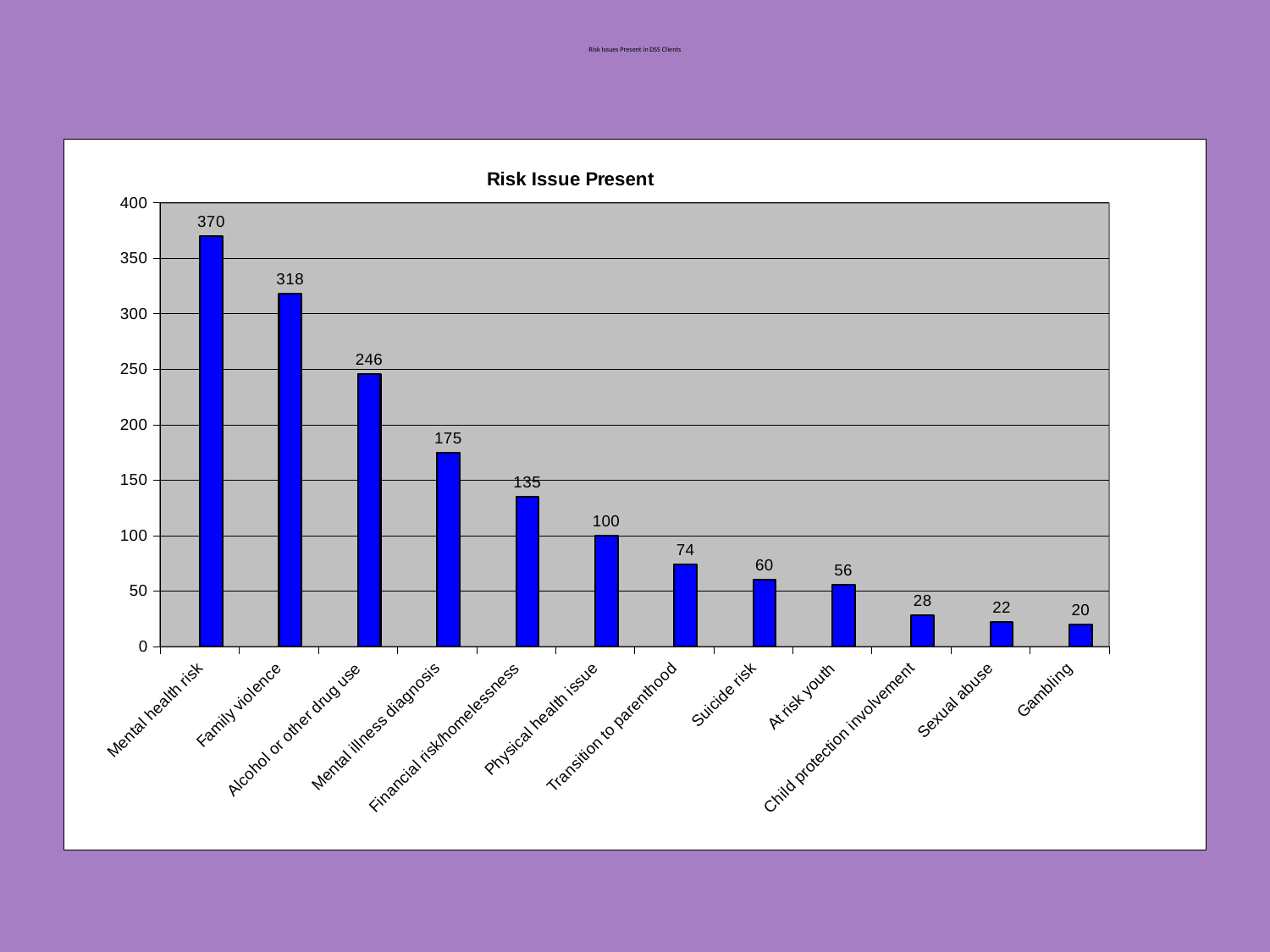
What kind of chart is shown on the slide? Bar chart What is the value for Financial risk/homelessness? 135 What is the title of the chart? Risk Issue Present What is the value for Mental health risk? 370 How many risk issue categories are shown on the chart? 12 Which is larger, the value for Suicide risk or the value for At risk youth? Suicide risk Which risk issue has the lowest value? Gambling What is the value for Child protection involvement? 28 Is the value for Mental illness diagnosis greater or less than 150? greater Which risk issue has the highest value? Mental health risk What is the difference between the values for Family violence and Alcohol or other drug use? 72 Do the values rise or fall from left to right along the x axis? Fall